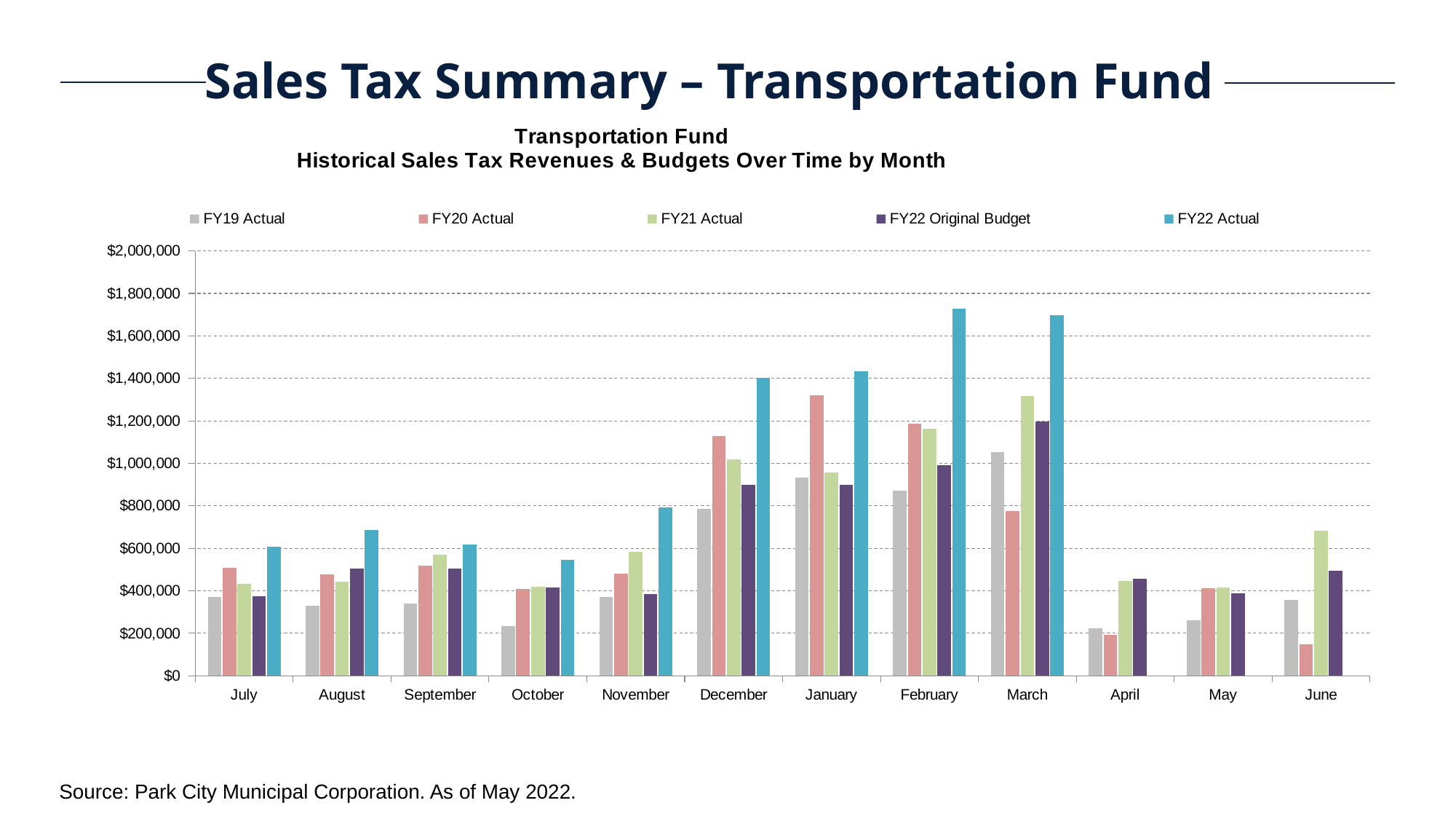
In June, which is larger: FY21 Actual or FY19 Actual? FY21 Actual How many months are shown on the x axis? 12 Is the FY22 Actual value for February greater or less than $1,600,000? greater In which month is the FY20 Actual value lowest? June In which month is the FY22 Actual value highest? February How many series does the legend list? 5 In December, which is larger: FY22 Actual or FY22 Original Budget? FY22 Actual Is the FY19 Actual value for October greater or less than $400,000? less Is the FY21 Actual value for March greater or less than $1,200,000? greater For how many months is an FY22 Actual bar plotted? 9 In which month is the FY20 Actual value highest? January What kind of chart is shown on the slide? Bar chart